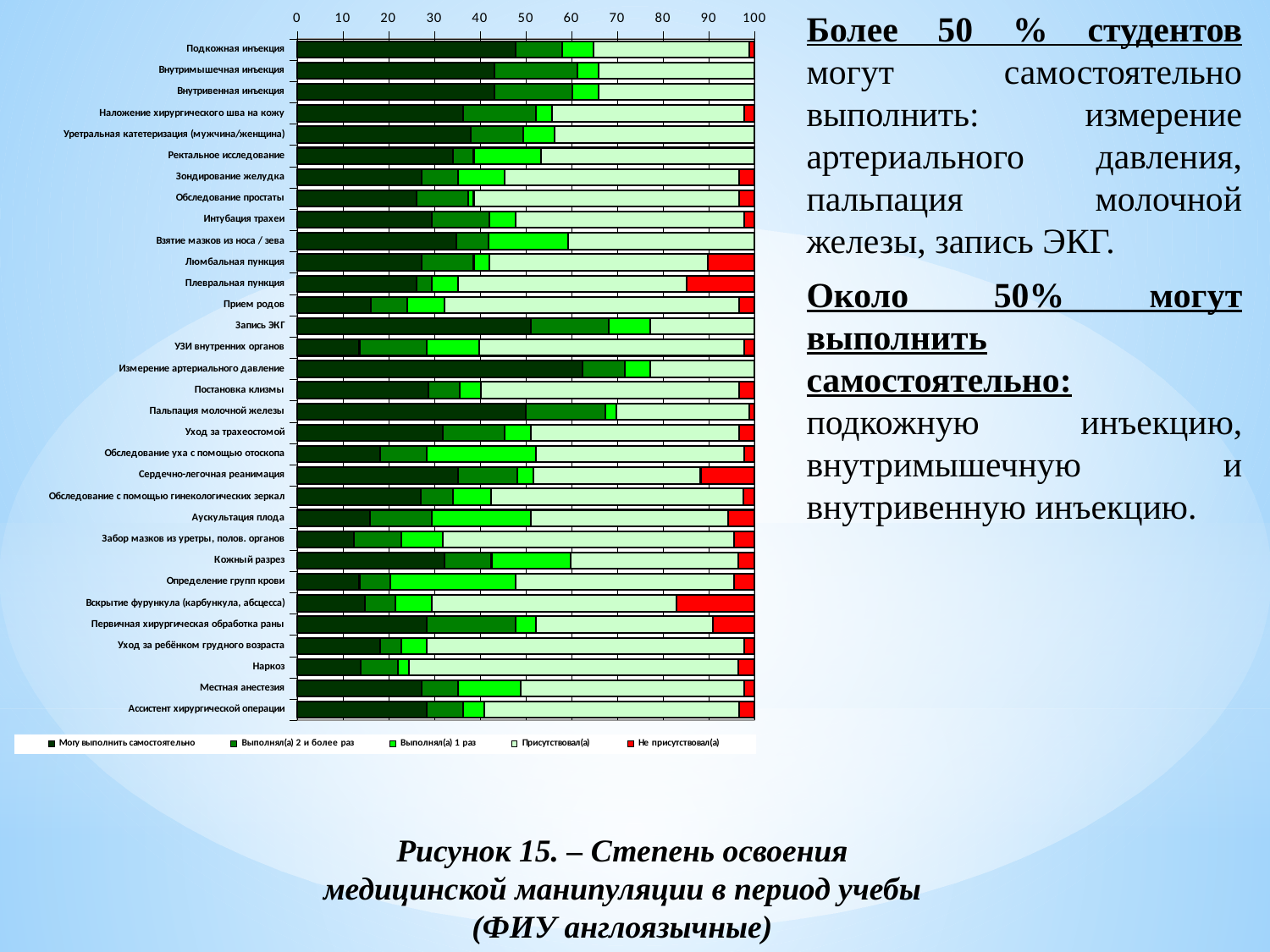
Which category has the largest 'Могу выполнить самостоятельно' segment? Измерение артериального давления Which has a larger 'Могу выполнить самостоятельно' segment: Подкожная инъекция or Наркоз? Подкожная инъекция Which has a larger 'Не присутствовал(а)' segment: Плевральная пункция or Подкожная инъекция? Плевральная пункция Is the 'Могу выполнить самостоятельно' value for Наркоз greater or less than 20? less What is the maximum value shown on the chart's horizontal axis? 100 How many medical manipulations (categories) are listed on the chart's vertical axis? 32 Is the 'Могу выполнить самостоятельно' value for Измерение артериального давления greater or less than 50? greater Which legend entry is shown in red? Не присутствовал(а) How many series does the chart legend list? 5 Is the 'Могу выполнить самостоятельно' value for Подкожная инъекция greater or less than 40? greater What kind of chart is shown on the slide? Stacked bar chart